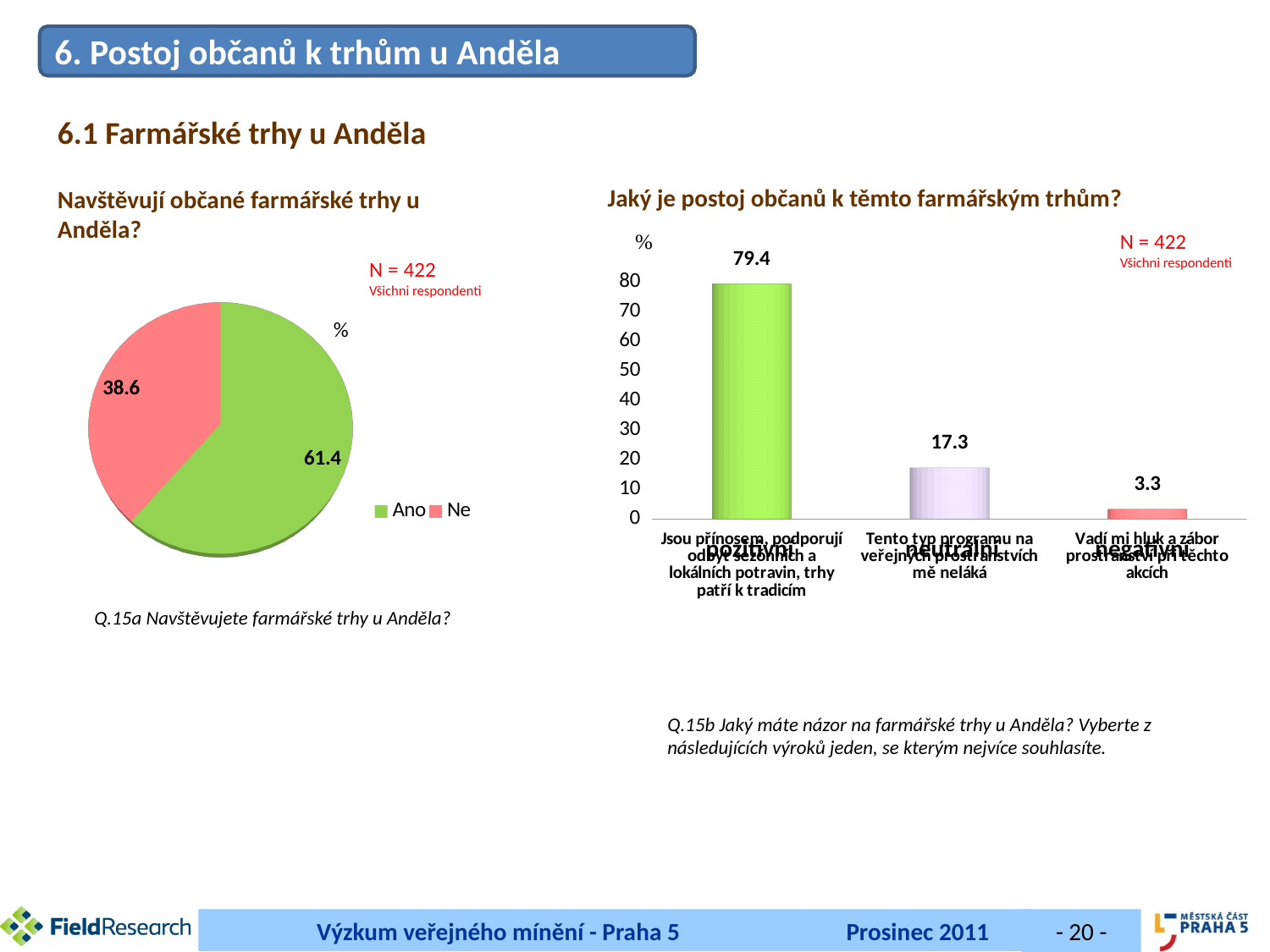
In the bar chart "Jaký je postoj občanů k těmto farmářským trhům?", what is the difference between the "pozitivní" and "neutrální" values? 62.1 In the pie chart on the left, what percentage of respondents answered "Ne"? 38.6 What type of chart is the chart on the left of the slide? Pie chart In the pie chart on the left, what percentage of respondents answered "Ano"? 61.4 In the bar chart "Jaký je postoj občanů k těmto farmářským trhům?", what is the value for the "neutrální" category? 17.3 In the pie chart on the left, what is the difference between the "Ano" and "Ne" shares? 22.8 In the pie chart on the left, which answer has the larger share, "Ano" or "Ne"? Ano How many entries does the legend of the pie chart on the left list? 2 In the bar chart "Jaký je postoj občanů k těmto farmářským trhům?", what is the value for the "pozitivní" category? 79.4 In the bar chart "Jaký je postoj občanů k těmto farmářským trhům?", which category has the lowest value? negativní What type of chart is the chart on the right of the slide? Bar chart How many categories are shown in the bar chart "Jaký je postoj občanů k těmto farmářským trhům?"? 3